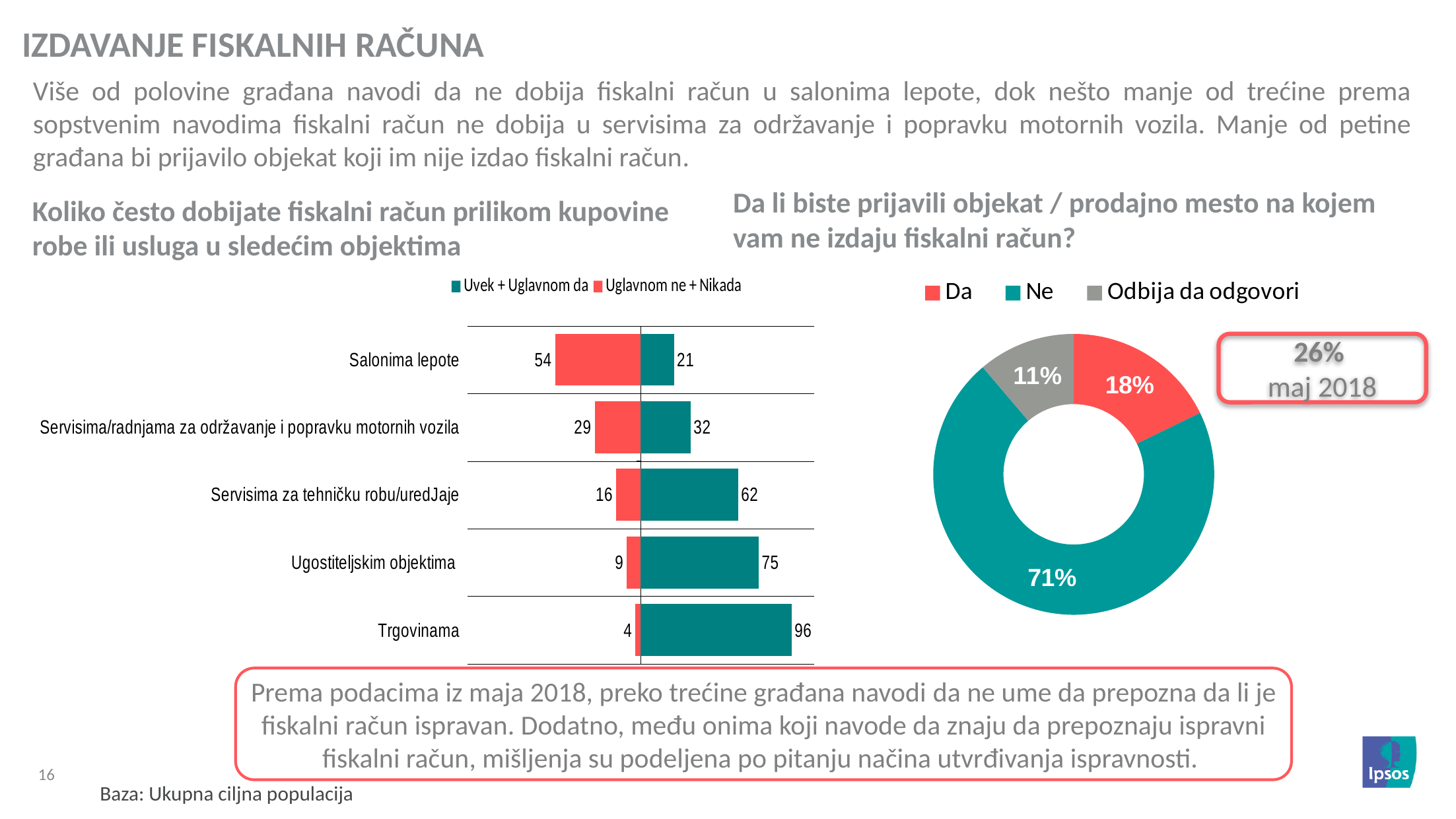
How many categories are shown in the bar chart on the left? 5 In the bar chart on the left, what is the value of 'Uvek + Uglavnom da' for Trgovinama? 96 In the bar chart on the left, which category has the highest 'Uglavnom ne + Nikada' value? Salonima lepote How many series does the legend of the bar chart on the left list? 2 In the bar chart on the left, what is the value of 'Uvek + Uglavnom da' for Servisima za tehničku robu/uredJaje? 62 What type of chart is shown on the right side of the slide? Donut (pie) chart In the bar chart on the left, which is larger for Servisima/radnjama za održavanje i popravku motornih vozila: 'Uvek + Uglavnom da' or 'Uglavnom ne + Nikada'? Uvek + Uglavnom da In the bar chart on the left, which category has the lowest 'Uvek + Uglavnom da' value? Salonima lepote In the donut chart on the right, what is the value for 'Odbija da odgovori'? 11% In the bar chart on the left, what is the value of 'Uglavnom ne + Nikada' for Salonima lepote? 54 In the bar chart on the left, what is the difference between the 'Uvek + Uglavnom da' values for Trgovinama and Ugostiteljskim objektima? 21 In the donut chart on the right, what share of respondents answered 'Ne'? 71%